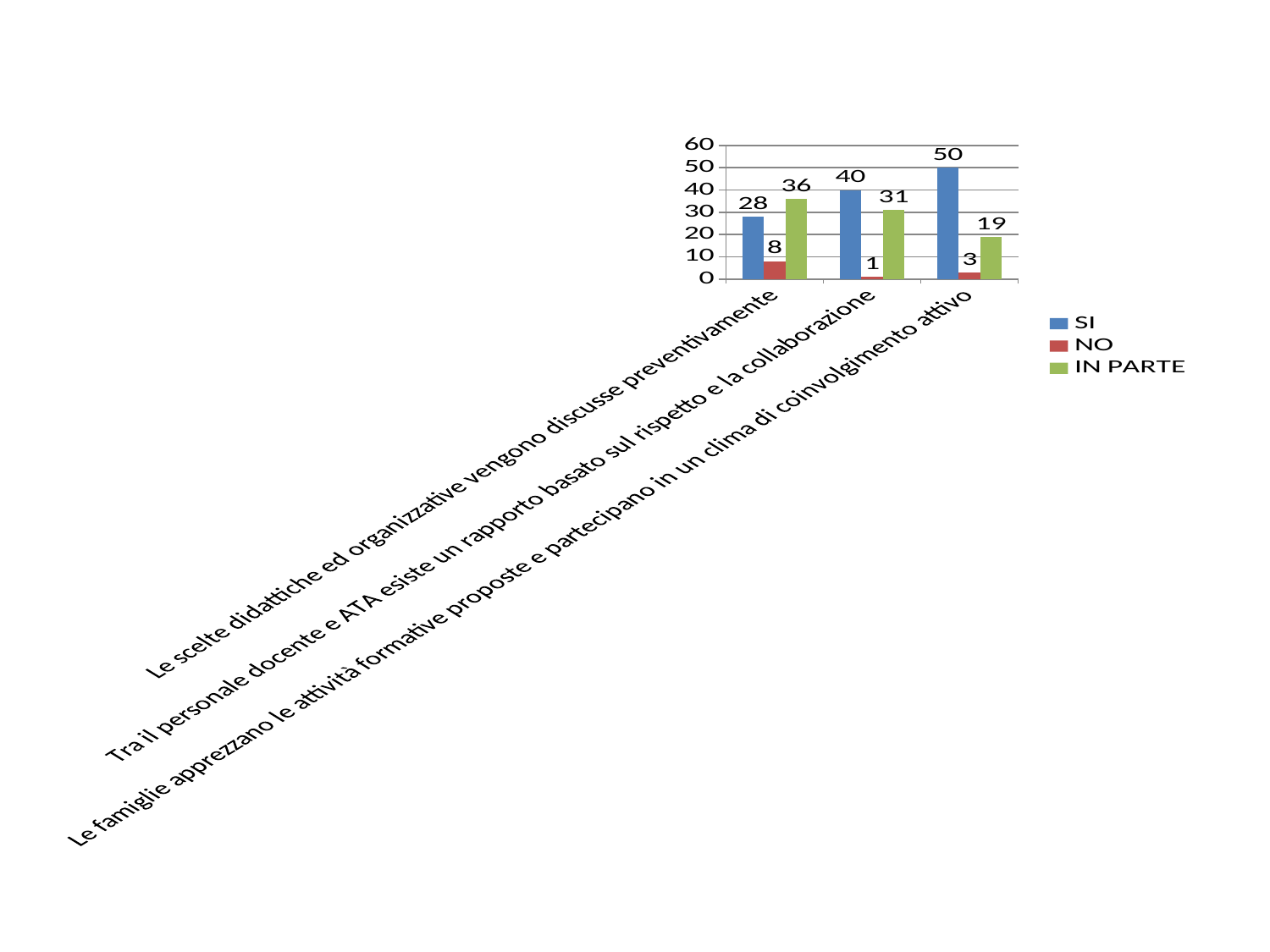
What is the NO value for "Le famiglie apprezzano le attività formative proposte e partecipano in un clima di coinvolgimento attivo"? 3 What kind of chart is shown on the slide? Bar chart What is the SI value for "Le scelte didattiche ed organizzative vengono discusse preventivamente"? 28 Which colour represents the NO series in the legend? Red Which category has the highest SI value? Le famiglie apprezzano le attività formative proposte e partecipano in un clima di coinvolgimento attivo How many series does the legend list? 3 Is the SI value for "Tra il personale docente e ATA esiste un rapporto basato sul rispetto e la collaborazione" greater or less than 30? greater Which category has the lowest NO value? Tra il personale docente e ATA esiste un rapporto basato sul rispetto e la collaborazione How many categories are shown on the x axis? 3 What is the difference between the SI and IN PARTE values for "Le famiglie apprezzano le attività formative proposte e partecipano in un clima di coinvolgimento attivo"? 31 What is the IN PARTE value for "Tra il personale docente e ATA esiste un rapporto basato sul rispetto e la collaborazione"? 31 For "Le scelte didattiche ed organizzative vengono discusse preventivamente", which is larger, SI or IN PARTE? IN PARTE